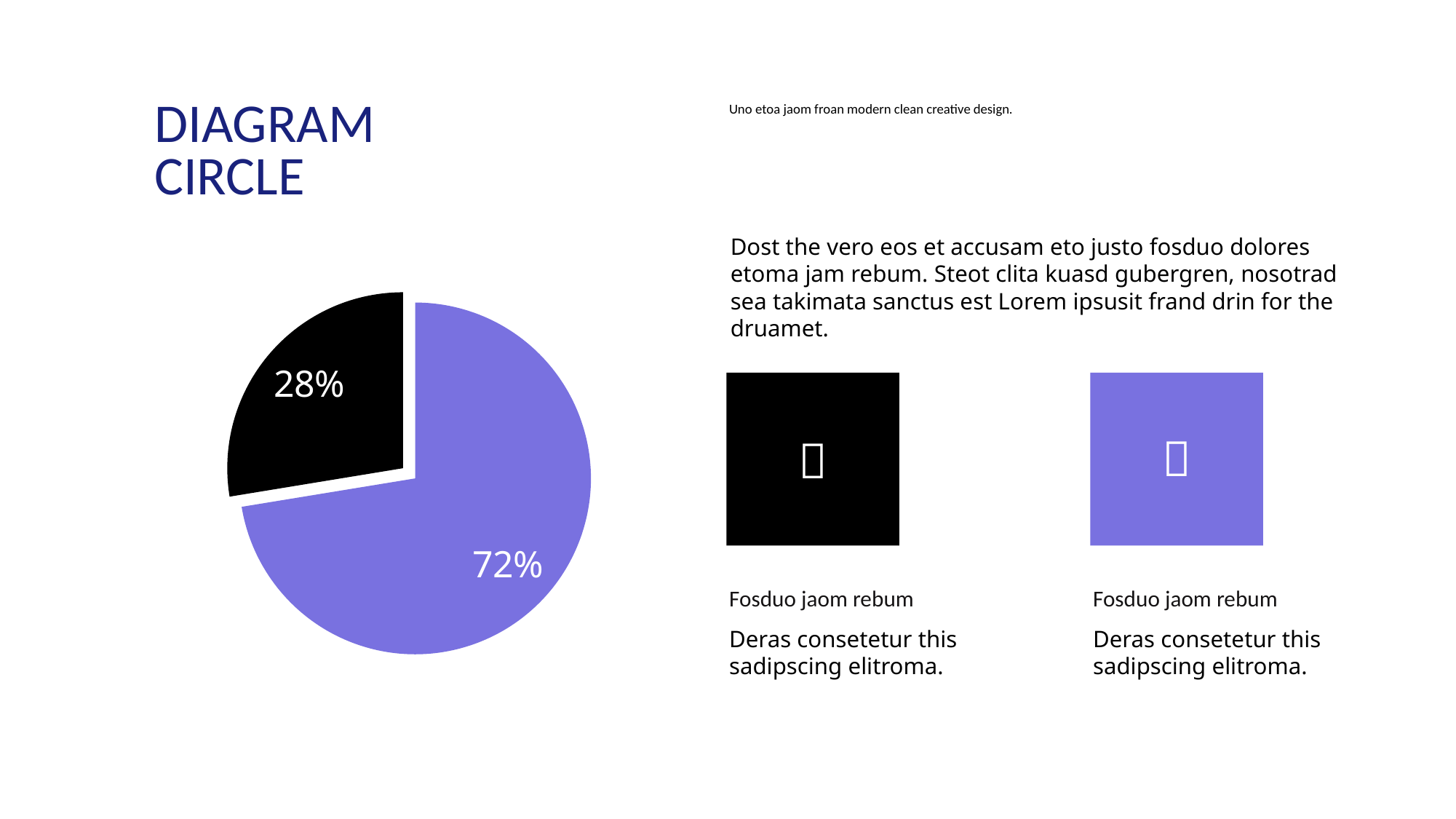
How many slices does the pie chart have? 2 What is the total of the two slices shown in the pie chart? 100% What is the difference between the purple slice and the black slice of the pie chart? 44% What share of the pie does the black slice represent? 28% Which slice of the pie chart is the smallest? the black slice (28%) Which slice of the pie chart is pulled out (exploded) from the rest of the pie? the black slice (28%) Which is larger in the pie chart, the black slice or the purple slice? the purple slice What colour is the slice labelled 72% in the pie chart? purple What value is shown on the black slice of the pie chart? 28% What kind of chart is shown on the slide? pie chart What value is shown on the purple slice of the pie chart? 72% Which slice of the pie chart is the largest? the purple slice (72%)